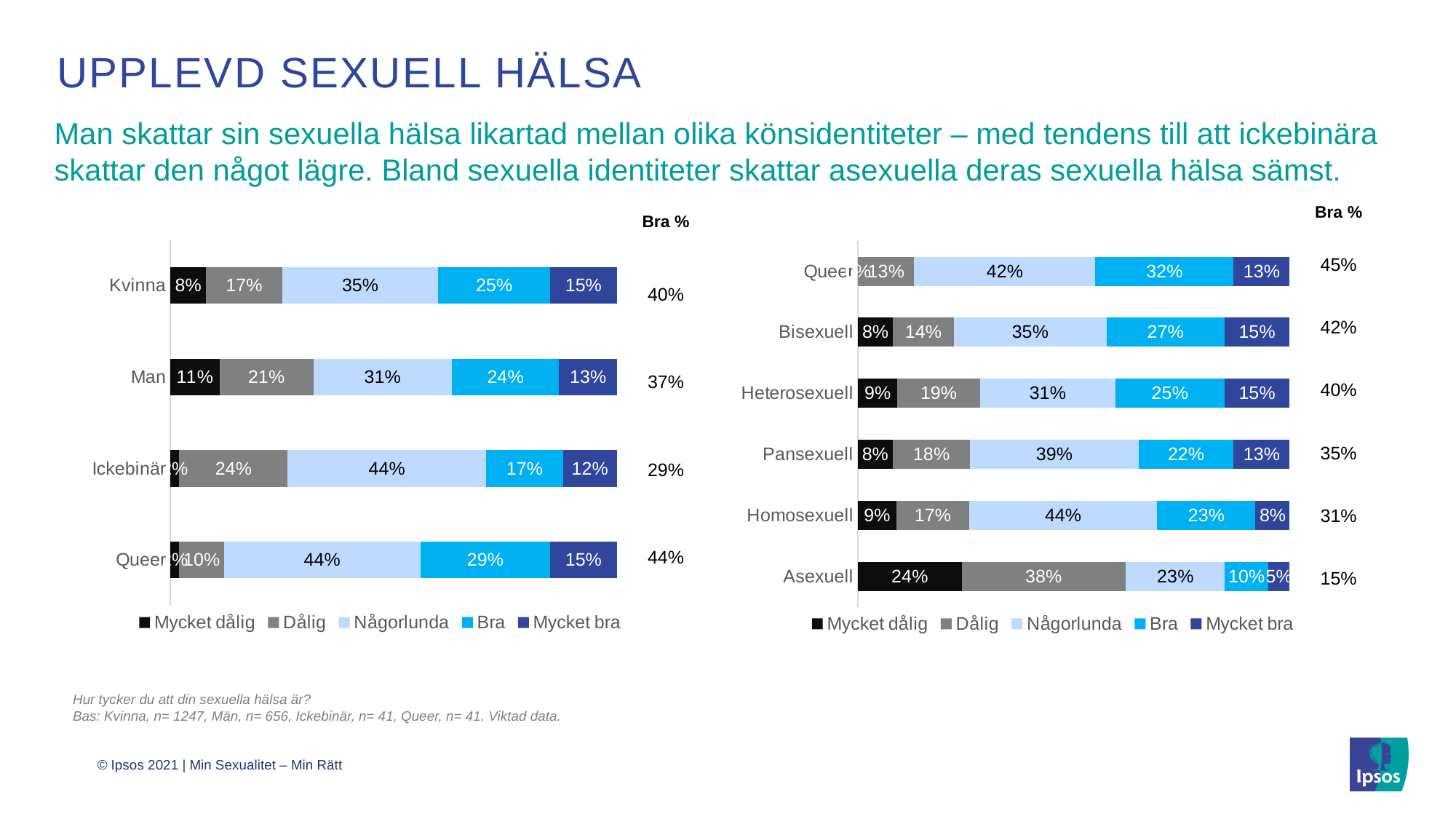
In the right chart, what percentage of Asexuell answered Mycket dålig? 24% In the right chart, which is larger: the Mycket bra share for Bisexuell or for Homosexuell? Bisexuell In the left chart, what percentage of Ickebinär answered Bra? 17% In the right chart, what percentage of Pansexuell answered Någorlunda? 39% In the right chart, which category has the lowest Bra % value shown to the right of the bars? Asexuell How many categories are shown in the right chart? 6 In the left chart, what is the difference between the Bra % values for Queer and Ickebinär? 15% How many series does the legend of the left chart list? 5 In the left chart, what percentage of Kvinna answered Någorlunda? 35% In the left chart, what percentage of Man answered Dålig? 21% In the right chart, which category has the highest Bra % value shown to the right of the bars? Queer What type of chart is the left chart? Stacked bar chart